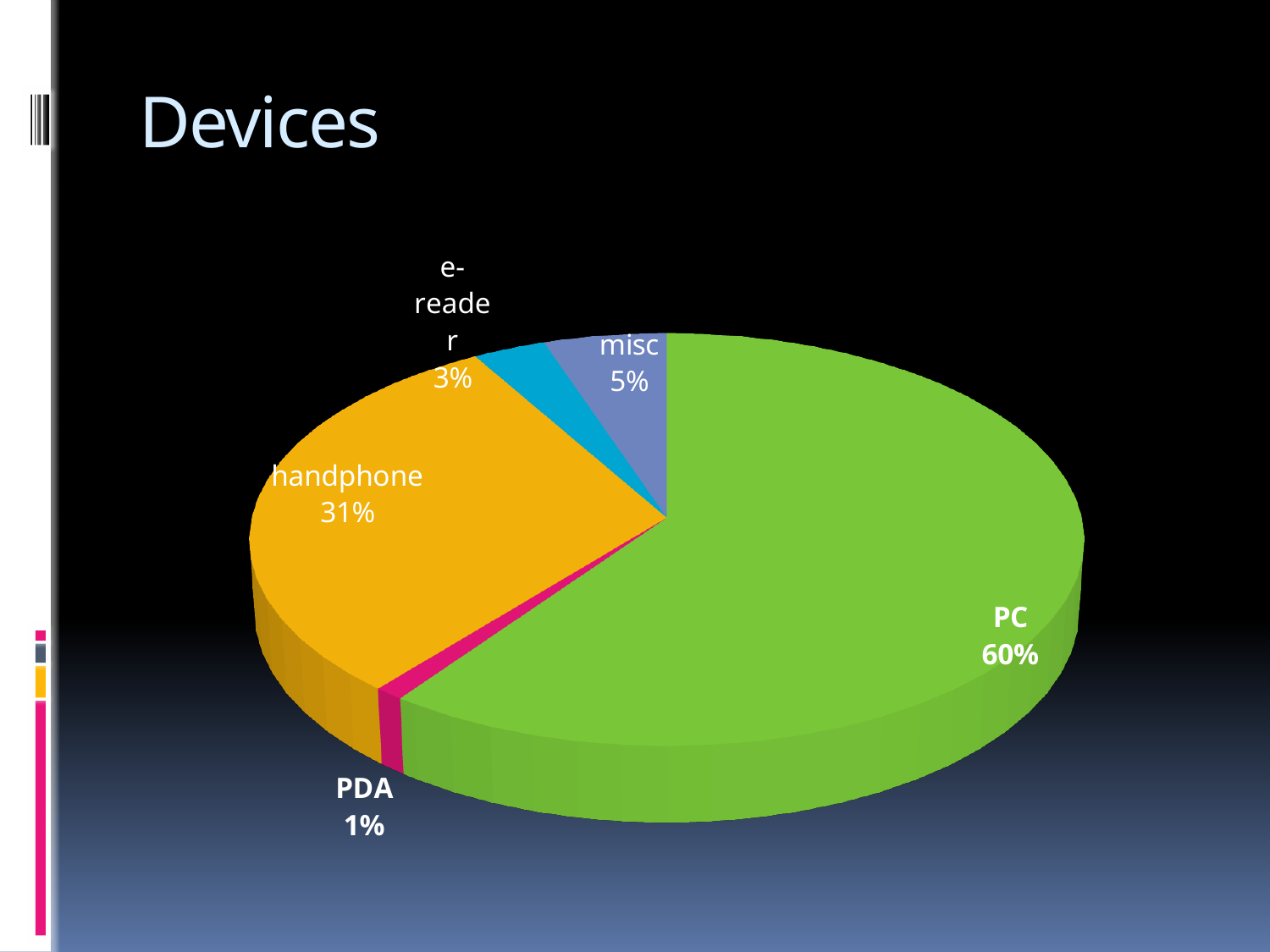
What kind of chart is shown on the slide? pie chart What is the value shown for PDA? 1% Which category has the smallest slice of the pie? PDA What is the title of the slide containing the chart? Devices What is the value shown for misc? 5% Which is larger, the share for misc or the share for e-reader? misc What share of the pie does handphone account for? 31% What share of the pie does PC account for? 60% What is the value shown for e-reader? 3% How many categories are shown in the pie chart? 5 Which category has the largest slice of the pie? PC What is the difference between the PC share and the handphone share? 29%